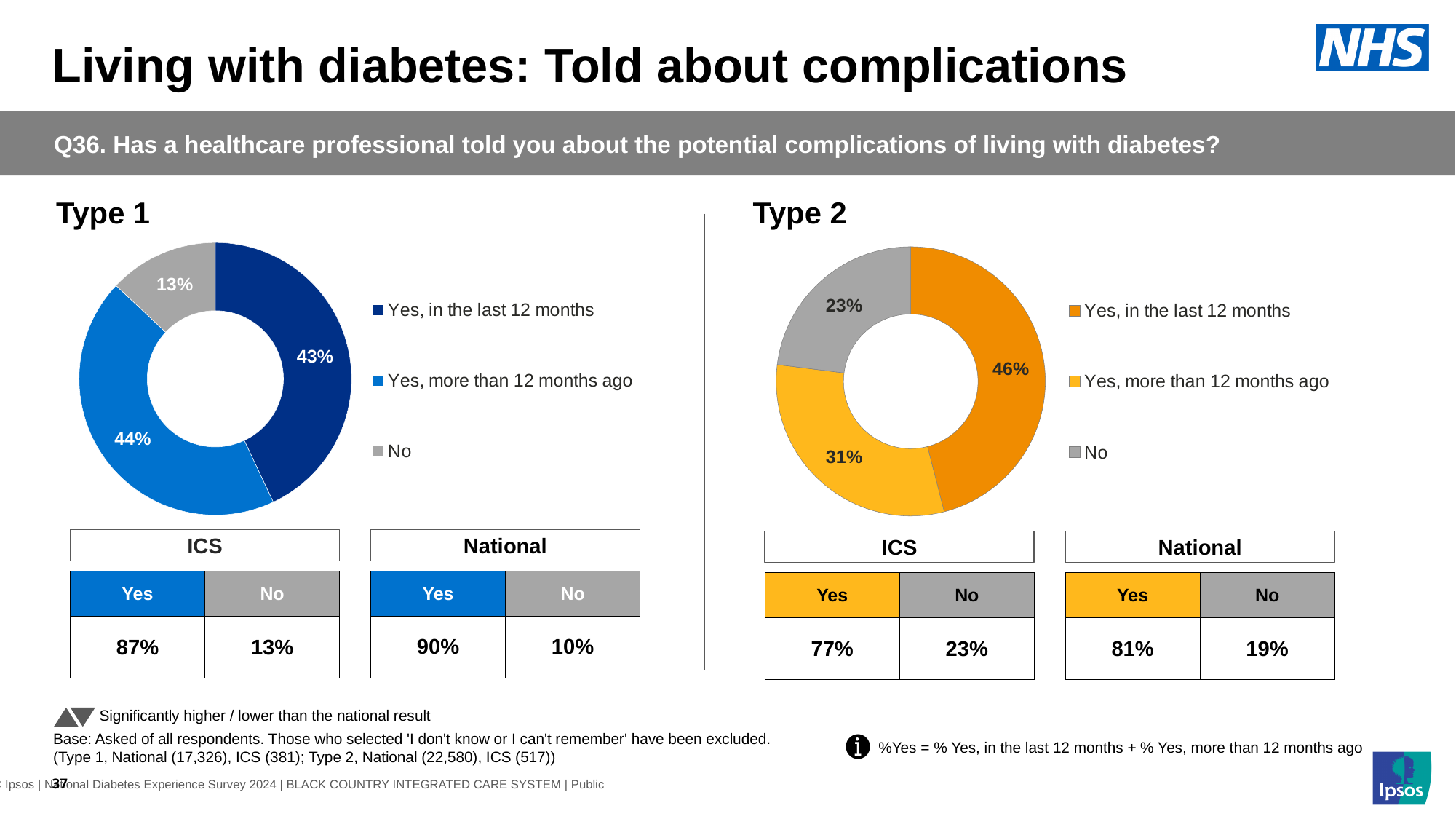
How many categories does the legend of the Type 1 chart list? 3 In the Type 2 chart, what percentage of respondents said 'No'? 23% In the Type 2 chart, what is the difference between the 'Yes, in the last 12 months' share and the 'No' share? 23% In the Type 1 chart, what percentage of respondents said 'Yes, in the last 12 months'? 43% Is the 'No' share larger in the Type 1 chart or the Type 2 chart? Type 2 In the Type 2 chart, what percentage of respondents said 'Yes, more than 12 months ago'? 31% What colour represents 'No' in both charts? Grey In the Type 2 chart, which category has the largest share? Yes, in the last 12 months What kind of chart is used for Type 1 and Type 2? Doughnut (pie) chart In the Type 1 chart, what percentage of respondents said 'No'? 13% In the Type 1 chart, which category has the smallest share? No In the Type 2 chart, which category has the smallest share? No